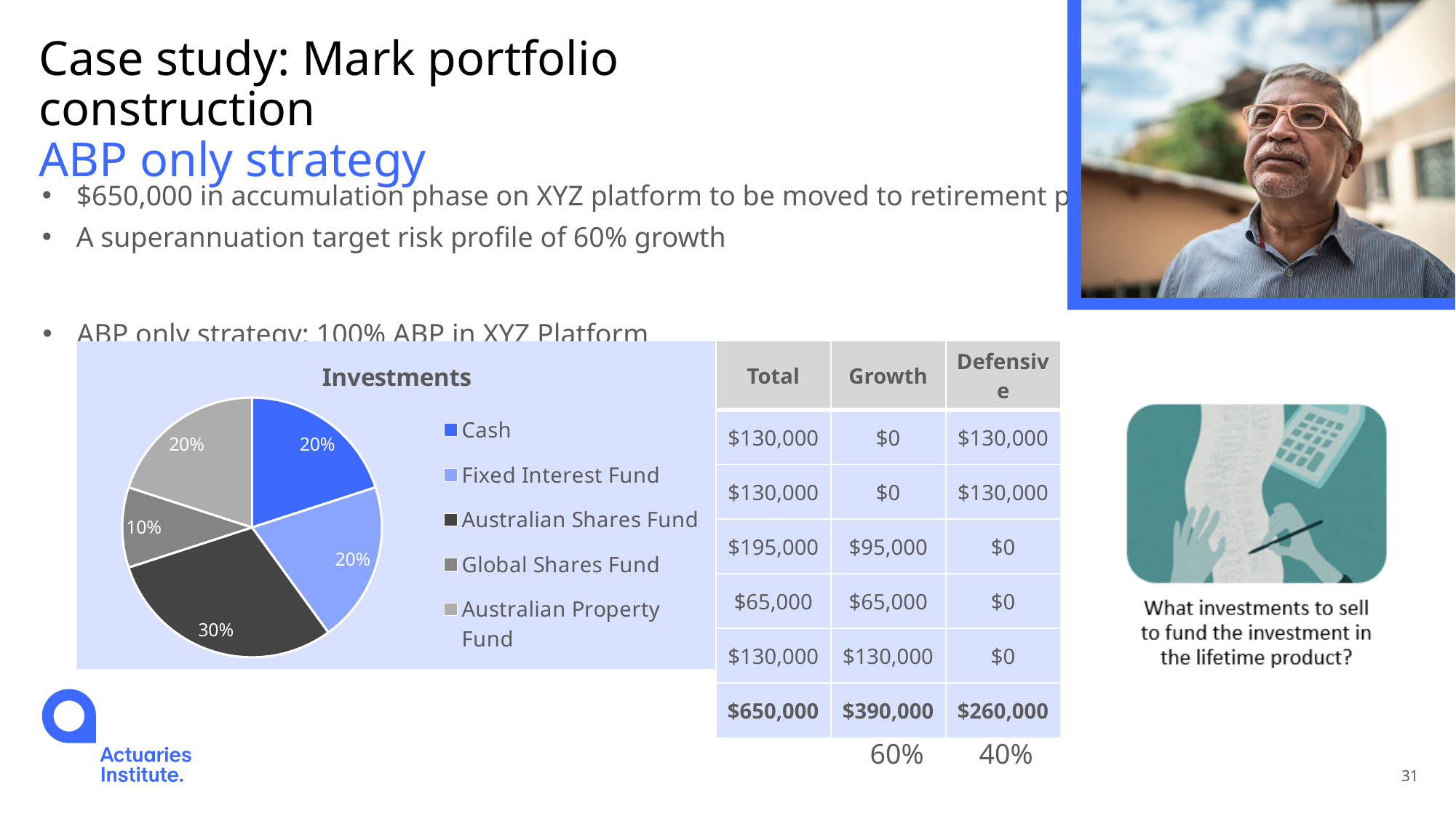
How many slices does the "Investments" pie chart have? 5 In the "Investments" pie chart, what share does the Australian Shares Fund have? 30% Which slice of the "Investments" pie chart is the largest? Australian Shares Fund What is the title of the pie chart on the slide? Investments In the "Investments" pie chart, which is larger: the Australian Shares Fund or Cash? Australian Shares Fund In the "Investments" pie chart, what share does the Global Shares Fund have? 10% In the "Investments" pie chart, what share does the Fixed Interest Fund have? 20% Which slice of the "Investments" pie chart is the smallest? Global Shares Fund In the "Investments" pie chart, what share does the Australian Property Fund have? 20% In the "Investments" pie chart, what is the difference in percentage points between the Australian Shares Fund and the Global Shares Fund? 20 percentage points What kind of chart is the "Investments" chart? pie chart In the "Investments" pie chart, what share does Cash have? 20%